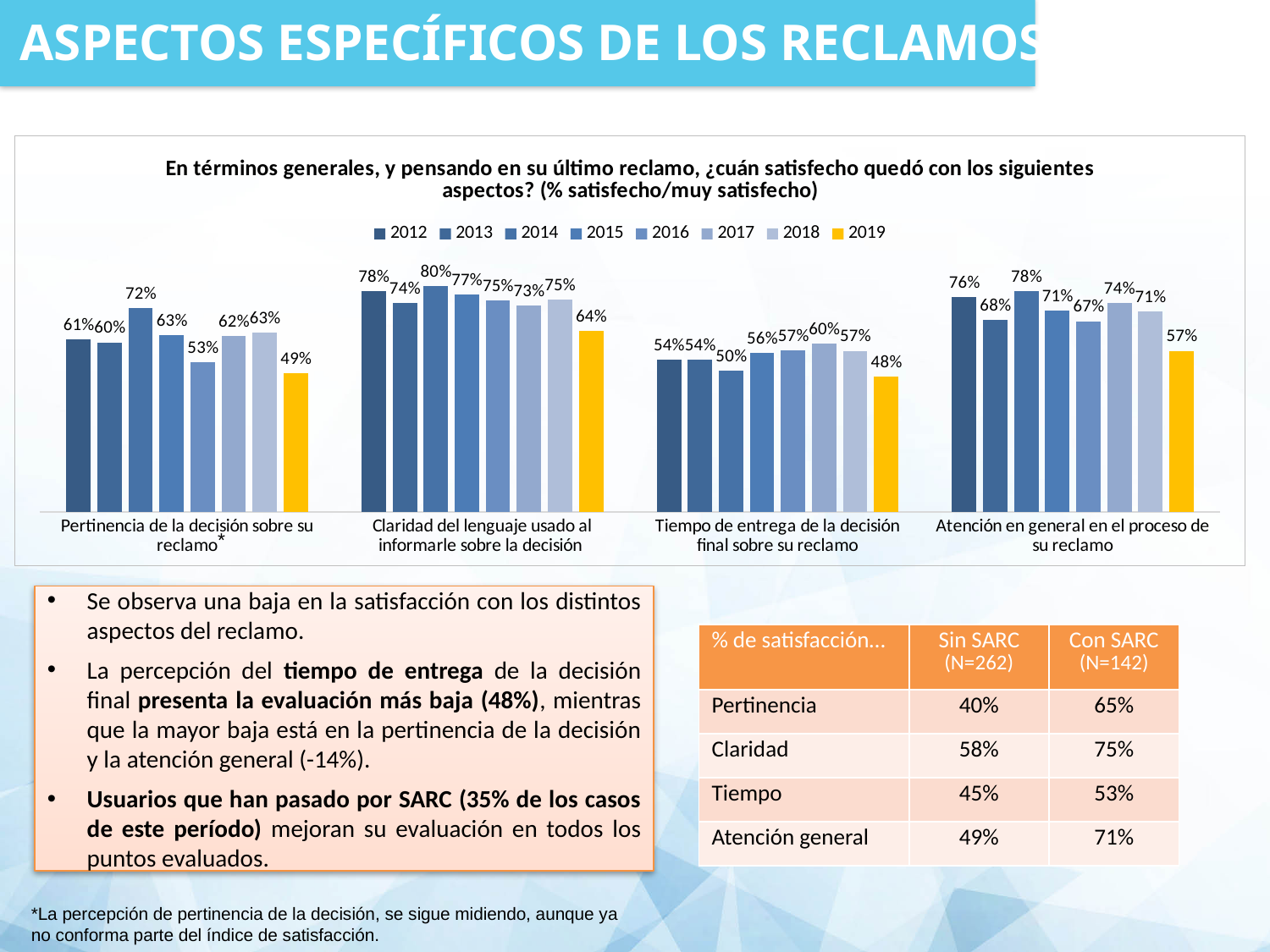
What is the 2016 value for 'Pertinencia de la decisión sobre su reclamo'? 53% What is the 2012 value for 'Atención en general en el proceso de su reclamo'? 76% What kind of chart is shown on the slide? Bar chart Which colour represents the 2019 series in the chart? Yellow Which year has the highest value for 'Pertinencia de la decisión sobre su reclamo'? 2014 What is the 2014 value for 'Claridad del lenguaje usado al informarle sobre la decisión'? 80% What is the difference between the 2018 and 2019 values for 'Atención en general en el proceso de su reclamo'? 14% How many categories are shown on the x axis of the chart? 4 Which is larger: the 2017 value for 'Tiempo de entrega de la decisión final sobre su reclamo' or the 2017 value for 'Pertinencia de la decisión sobre su reclamo'? Pertinencia de la decisión sobre su reclamo How many series does the chart legend list? 8 Which year has the lowest value for 'Atención en general en el proceso de su reclamo'? 2019 What is the 2019 value for 'Tiempo de entrega de la decisión final sobre su reclamo'? 48%